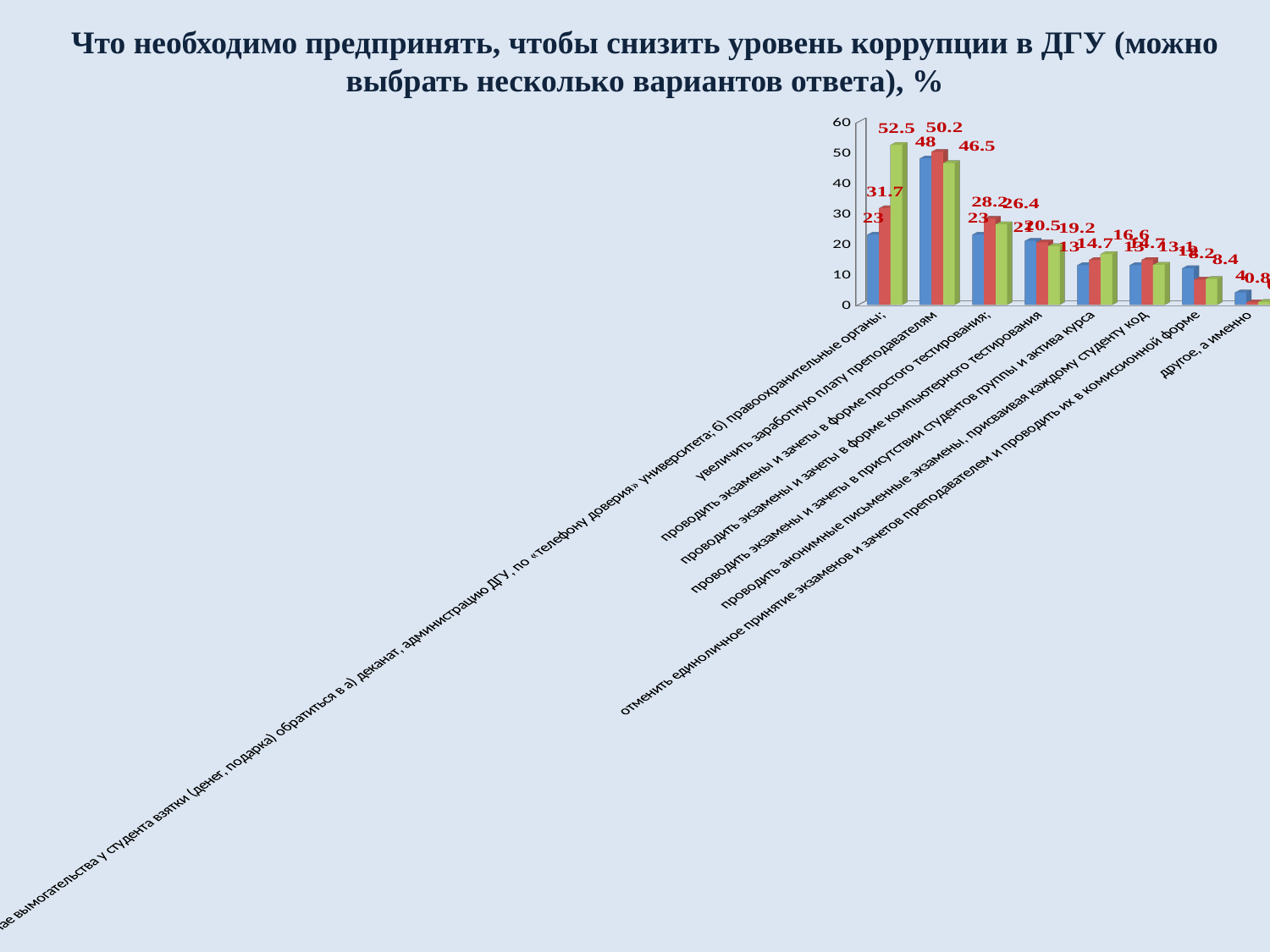
Is the value of the blue bar for the category "проводить экзамены и зачеты в форме компьютерного тестирования" greater or less than 30? less What is the highest value labelled anywhere on the chart? 52.5 Which is larger for the category "увеличить заработную плату преподавателям": the red bar or the green bar? the red bar How many answer categories are plotted along the x axis of the chart? 8 What is the value of the green bar for the category "проводить экзамены и зачеты в присутствии студентов группы и актива курса"? 16.6 What is the value of the blue bar for the category "увеличить заработную плату преподавателям"? 48 What kind of chart is shown on the slide? bar chart What is the value of the red bar for the category "увеличить заработную плату преподавателям"? 50.2 What is the value of the green bar for the category "проводить экзамены и зачеты в форме простого тестирования"? 26.4 What is the difference between the red bar (28.2) and the blue bar (23) for the category "проводить экзамены и зачеты в форме простого тестирования"? 5.2 What is the value of the red bar for the category "проводить экзамены и зачеты в форме простого тестирования"? 28.2 What is the value of the green bar for the category "увеличить заработную плату преподавателям"? 46.5